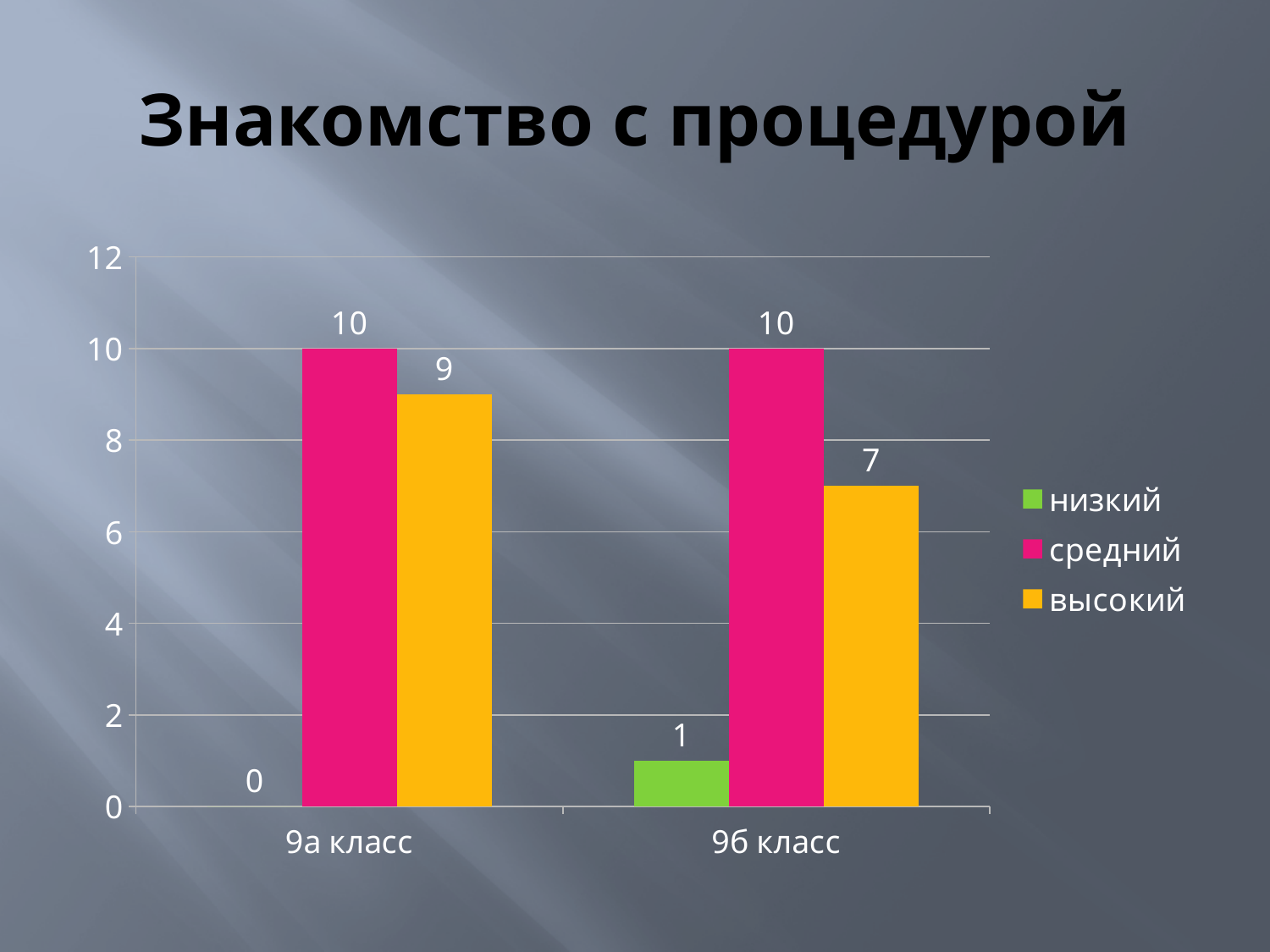
What is the value for "низкий" in 9б класс? 1 What is the value for "низкий" in 9а класс? 0 Which series has the highest value in 9б класс? средний Which series has the lowest value in 9а класс? низкий What is the value for "высокий" in 9б класс? 7 How many series does the legend list? 3 What is the value for "средний" in 9а класс? 10 What is the difference between the "высокий" values for 9а класс and 9б класс? 2 What colour represents the "средний" series? pink Which is larger: "высокий" in 9а класс or "высокий" in 9б класс? 9а класс What kind of chart is shown on the slide? bar chart How many categories are shown on the x axis? 2